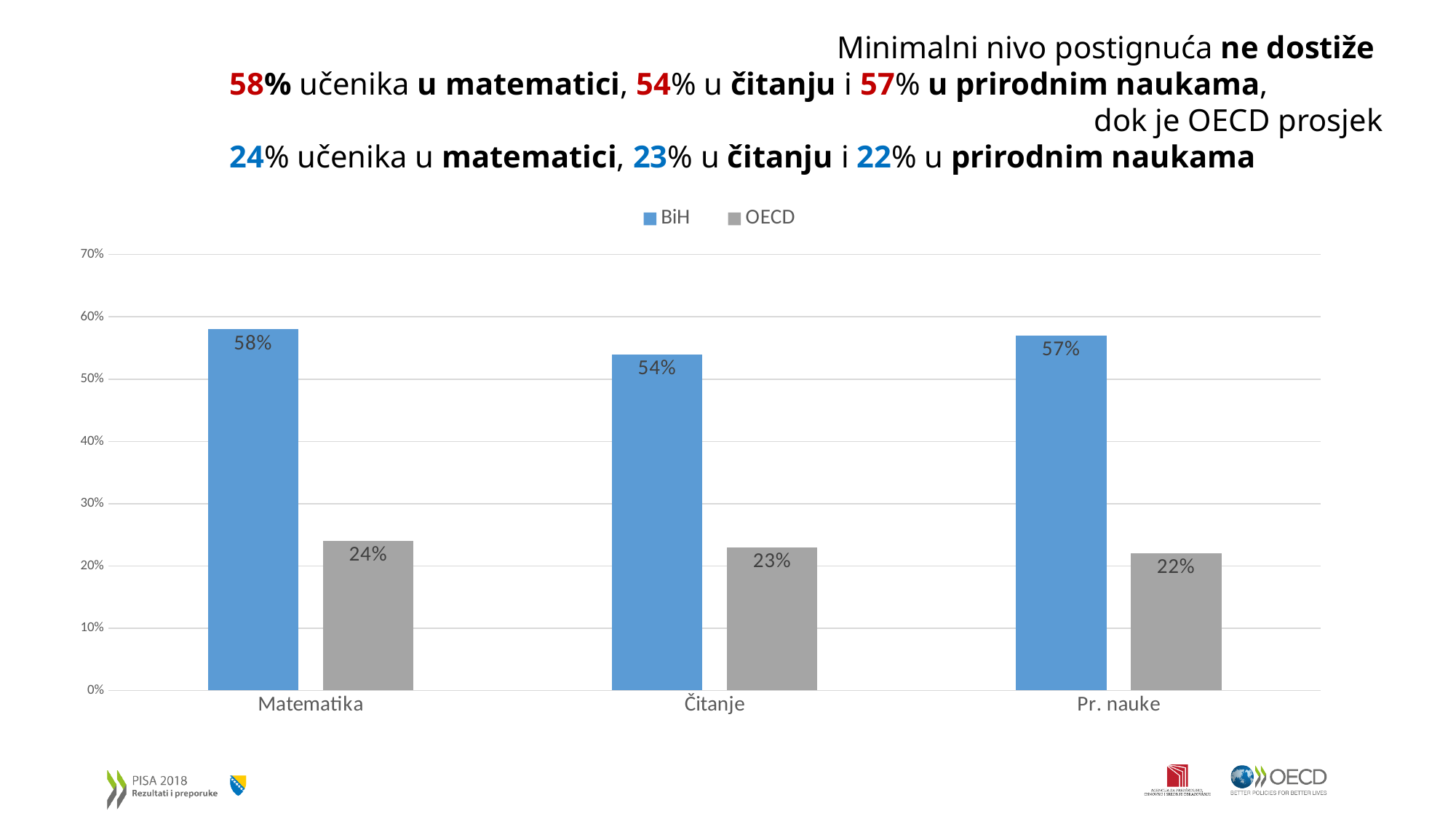
What is the OECD value for Čitanje? 23% Which is larger for Čitanje, the BiH value or the OECD value? BiH What kind of chart is shown on the slide? Bar chart How many series does the legend list? 2 What is the BiH value for Pr. nauke? 57% How many categories are shown on the x axis? 3 What is the BiH value for Matematika? 58% What colour are the BiH bars? Blue What is the OECD value for Pr. nauke? 22% Which category has the highest BiH value? Matematika What is the difference between the BiH and OECD values for Matematika? 34% Which category has the lowest OECD value? Pr. nauke